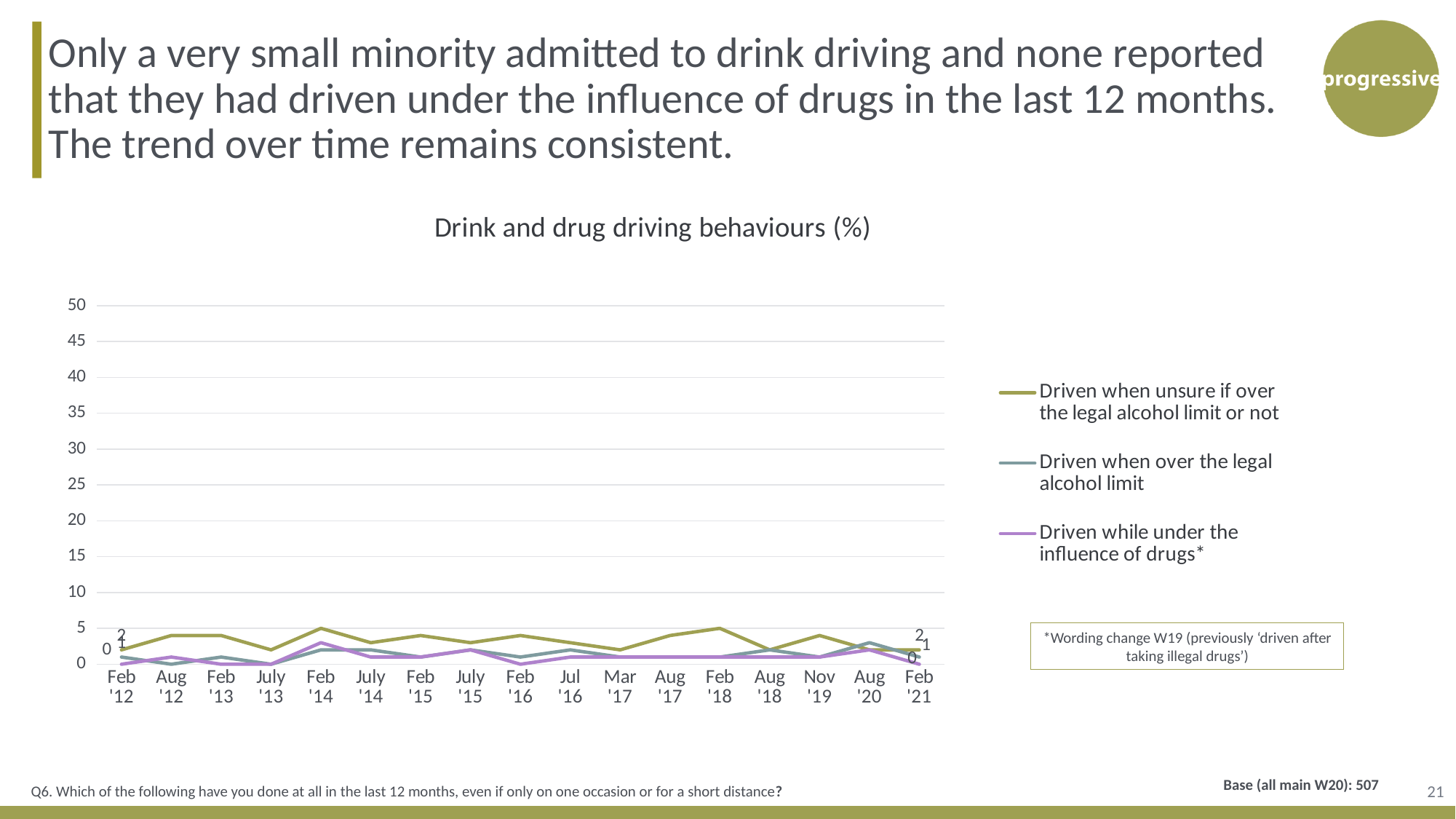
Is the value for 'Driven when unsure if over the legal alcohol limit or not' in Feb '18 greater or less than 10? less What is the title of the chart? Drink and drug driving behaviours (%) In Feb '12, which is larger: 'Driven when unsure if over the legal alcohol limit or not' or 'Driven while under the influence of drugs'? Driven when unsure if over the legal alcohol limit or not What kind of chart is shown on the slide? line chart What is the value for 'Driven when unsure if over the legal alcohol limit or not' in Feb '12? 2 What is the value for 'Driven when unsure if over the legal alcohol limit or not' in Feb '21? 2 How many series does the legend list? 3 Which series is drawn in purple? Driven while under the influence of drugs* What is the value for 'Driven while under the influence of drugs' in Feb '21? 0 What is the value for 'Driven when over the legal alcohol limit' in Feb '21? 1 How many time points are shown on the x axis? 17 What is the difference between 'Driven when unsure if over the legal alcohol limit or not' and 'Driven while under the influence of drugs' in Feb '21? 2